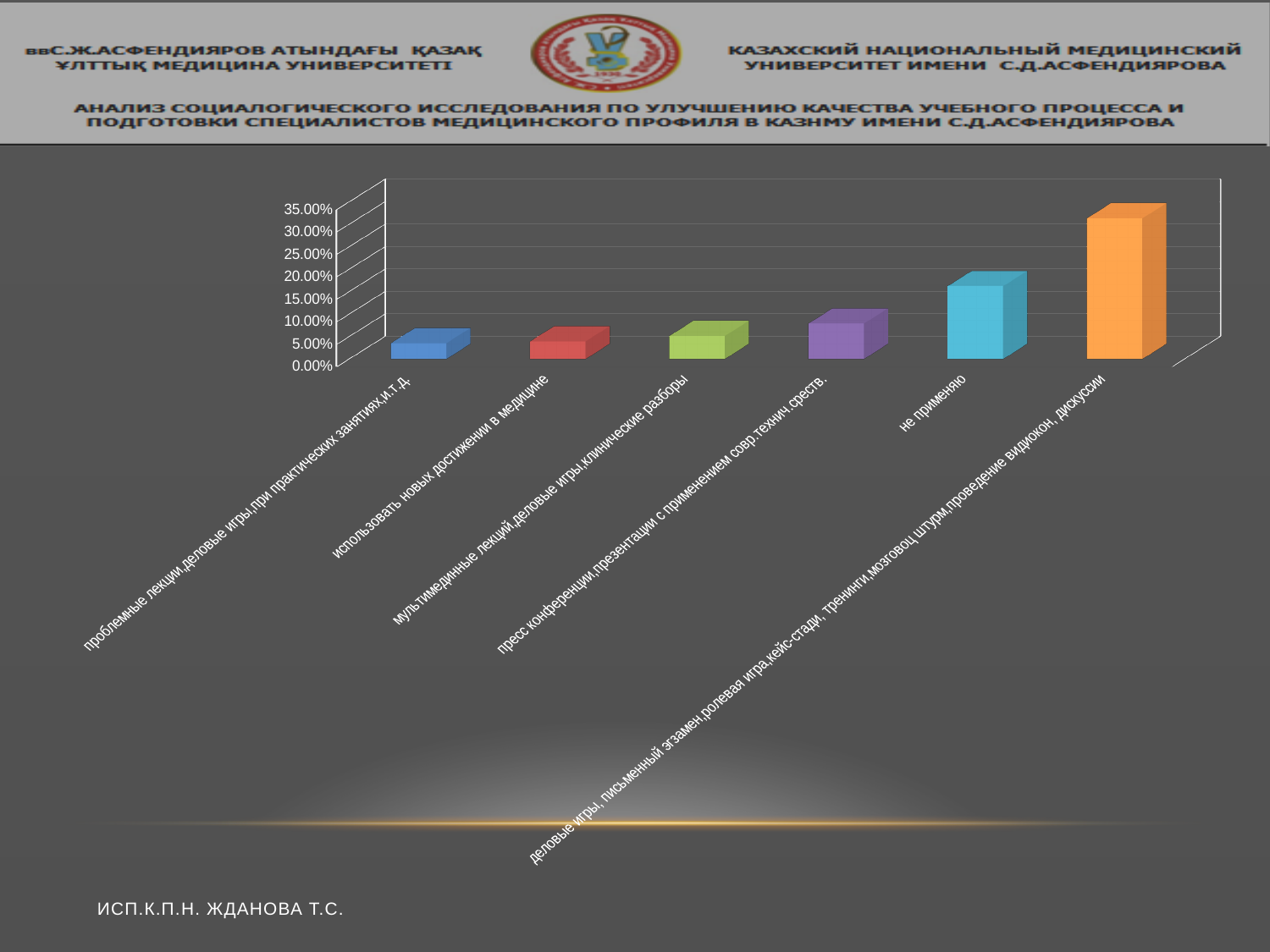
Is the value for "не применяю" greater or less than 10.00%? greater Is the value for "не применяю" greater or less than 25.00%? less Which is larger: the value for "не применяю" or the value for "использовать новых достижении в медицине"? не применяю How many categories are plotted in the chart? 6 Is the value for "проблемные лекции,деловые игры,при практических занятиях,и.т.д." greater or less than 10.00%? less Which category has the highest value in the chart? деловые игры, письменный эгзамен,ролевая игра,кейс-стади, тренинги,мозговоц штурм,проведение видиокон, дискуссии What is the highest value shown on the vertical axis of the chart? 35.00% Which is larger: the value for "деловые игры, письменный экзамен,ролевая игра,кейс-стади, тренинги,мозговоц штурм,проведение видиокон, дискуссии" or the value for "не применяю"? деловые игры, письменный экзамен,ролевая игра,кейс-стади, тренинги,мозговоц штурм,проведение видиокон, дискуссии What kind of chart is shown on the slide? bar chart Do the values generally rise or fall from left to right along the x axis? rise